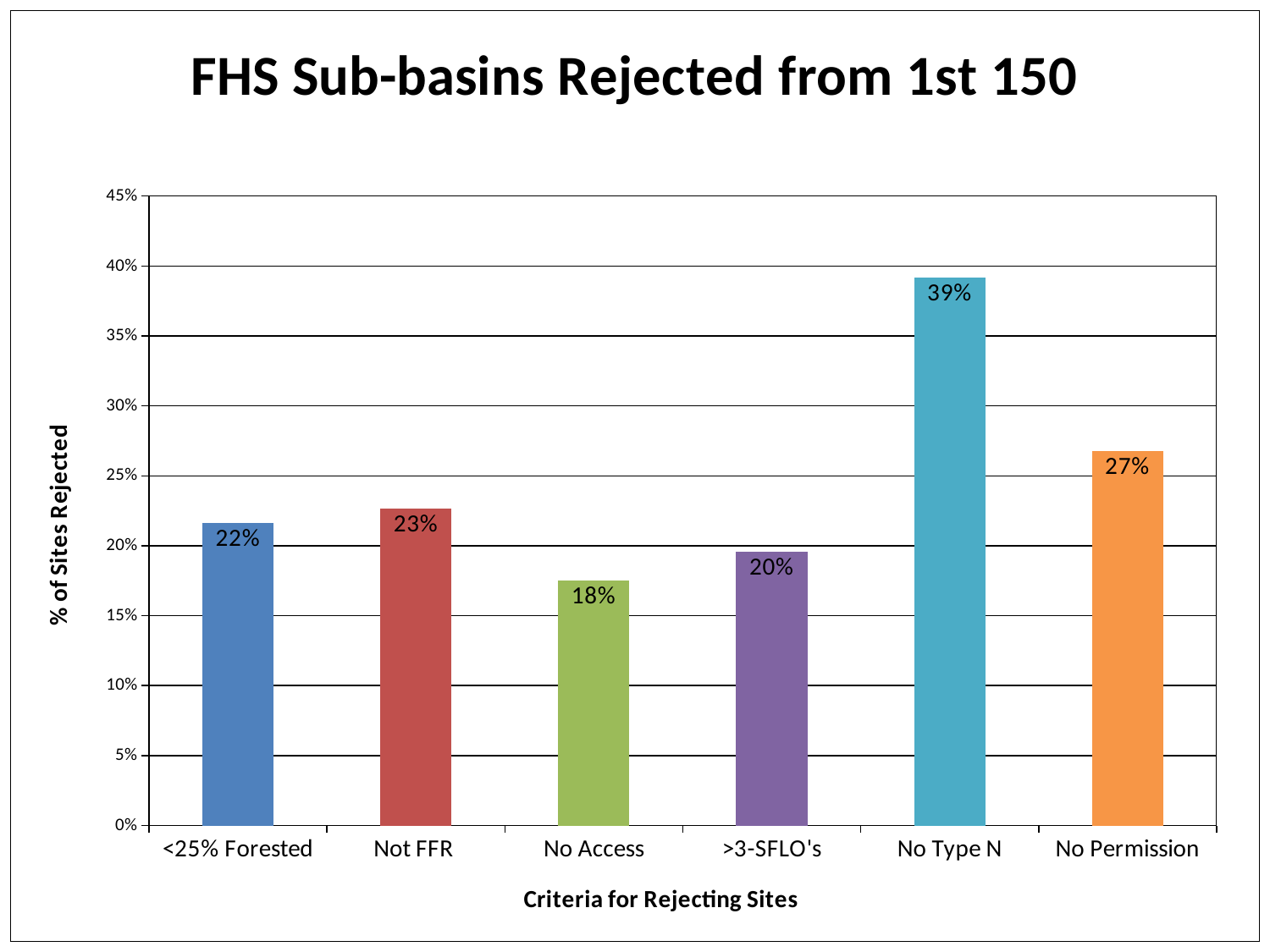
Which is larger, the value for Not FFR or the value for >3-SFLO's? Not FFR Which criterion has the lowest percentage of sites rejected? No Access What is the difference between the values for No Type N and No Permission? 12% What is the value for <25% Forested? 22% How many criteria are shown on the x axis? 6 What kind of chart is shown on the slide? Bar chart Which criterion has the highest percentage of sites rejected? No Type N What is the value for No Access? 18% Is the value for No Type N greater or less than 35%? greater What is the value for No Type N? 39% What is the title of the chart? FHS Sub-basins Rejected from 1st 150 What is the value for No Permission? 27%